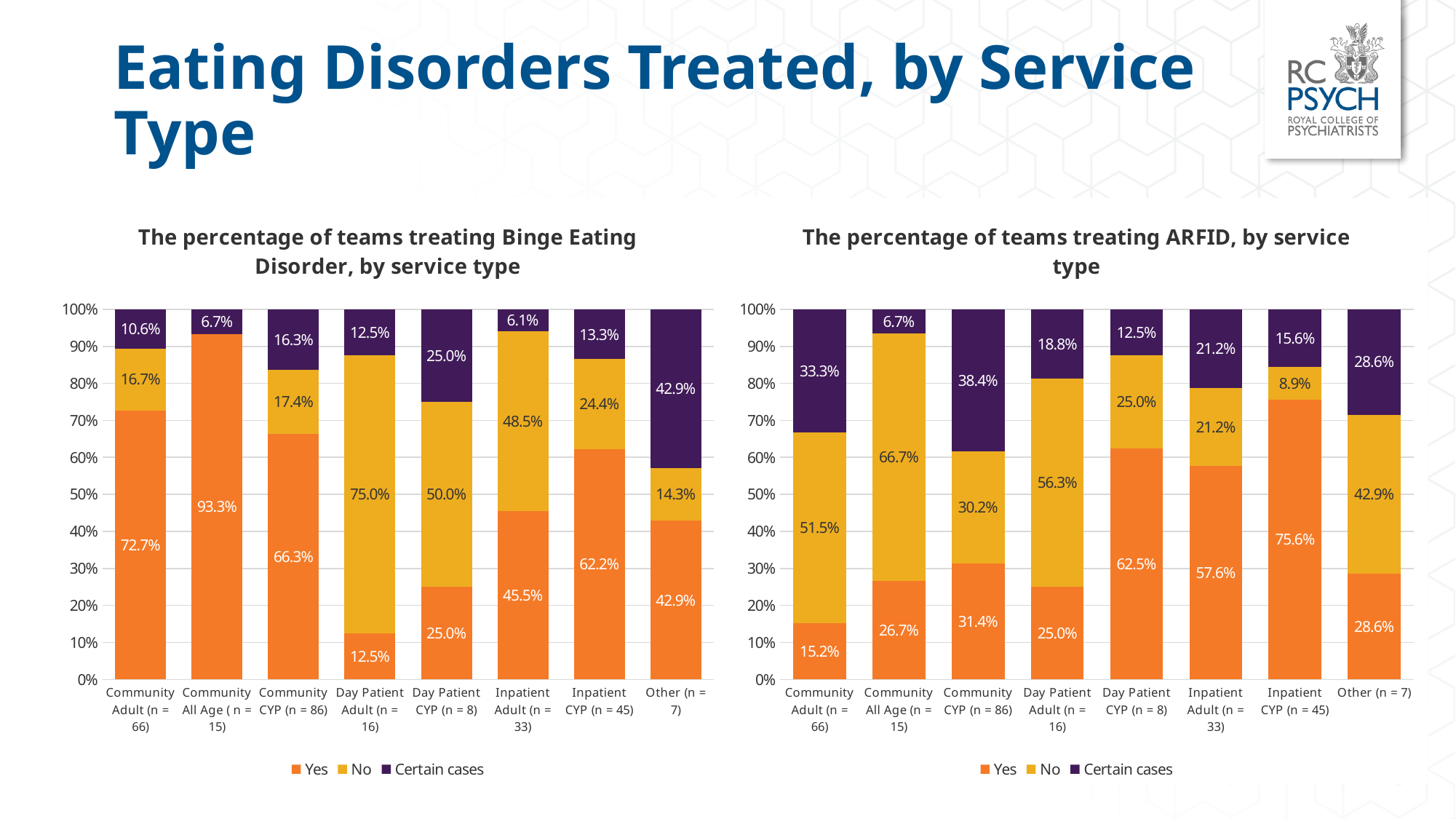
How many series does the legend of the Binge Eating Disorder chart list? 3 In the ARFID chart, what is the difference between the 'Yes' percentages for Inpatient CYP and Community Adult? 60.4% In the ARFID chart, what is the 'No' percentage for Community Adult (n = 66)? 51.5% In the ARFID chart, which service type has the highest 'Yes' percentage? Inpatient CYP (n = 45) How many service type categories are shown on the x axis of the ARFID chart? 8 In the ARFID chart, is the 'Certain cases' percentage for Community CYP greater or less than 30%? greater In the Binge Eating Disorder chart, what is the 'Certain cases' percentage for Other (n = 7)? 42.9% In the Binge Eating Disorder chart, which service type has the highest 'Yes' percentage? Community All Age (n = 15) What kind of chart is used for the ARFID data? Stacked bar chart In the Binge Eating Disorder chart, is the 'Yes' percentage larger for Inpatient Adult or Inpatient CYP? Inpatient CYP In the Binge Eating Disorder chart, which service type has the lowest 'Yes' percentage? Day Patient Adult (n = 16) In the Binge Eating Disorder chart, what percentage of Community All Age teams answered Yes? 93.3%